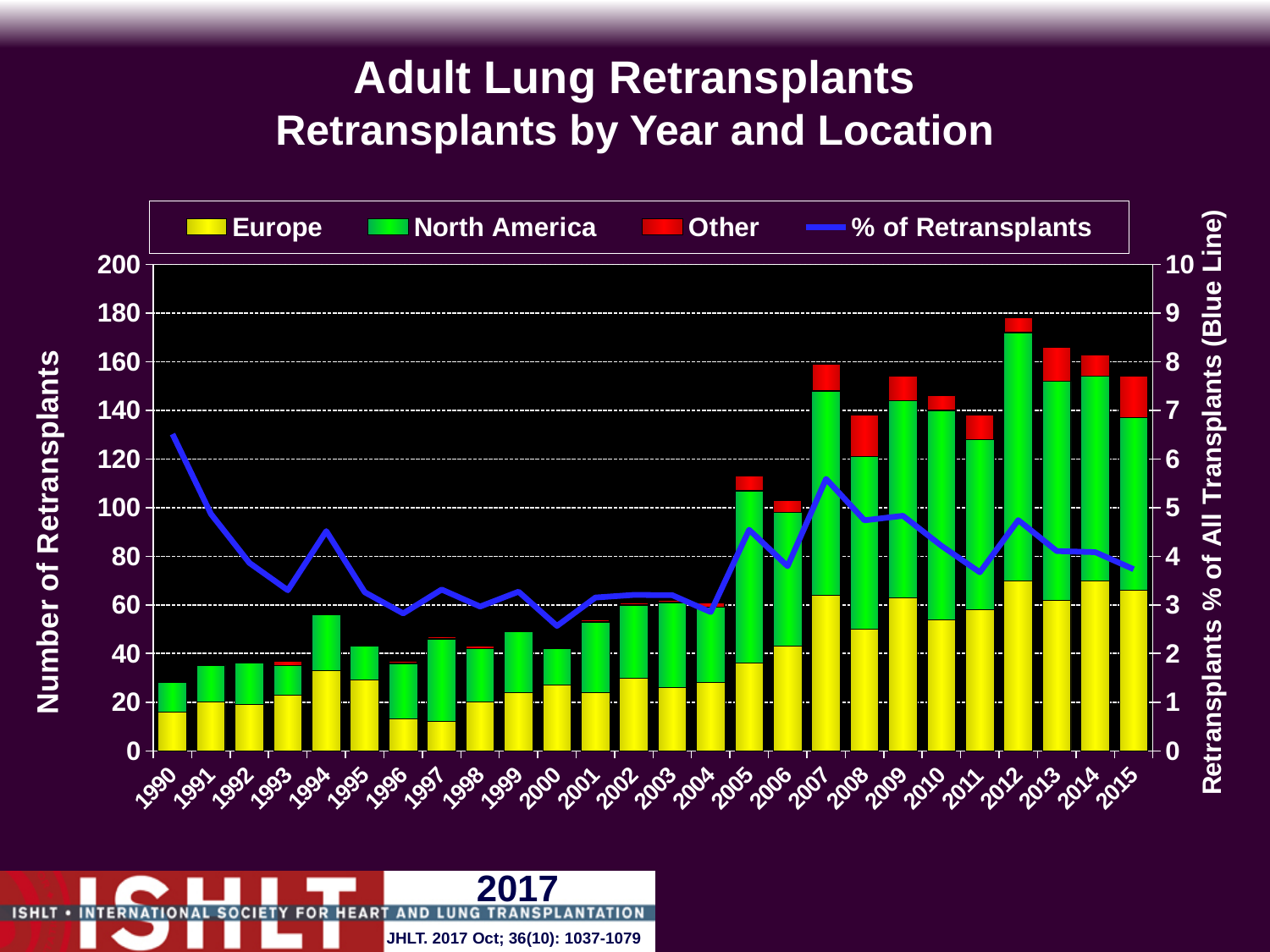
Is the total number of retransplants in 2012 greater or less than 160? greater Which year has the tallest total bar? 2012 Which year has the shortest total bar? 1990 Is the total number of retransplants in 1990 greater or less than 40? less Does the % of Retransplants line rise or fall from 1990 to 1993? fall How many series does the legend list? 4 Which colour represents Europe in the chart? Yellow Which year has a taller total bar, 2006 or 2007? 2007 Is the % of Retransplants line value in 1990 greater or less than 6? greater What kind of chart is shown on the slide? Stacked bar chart with a line How many years are shown along the x axis? 26